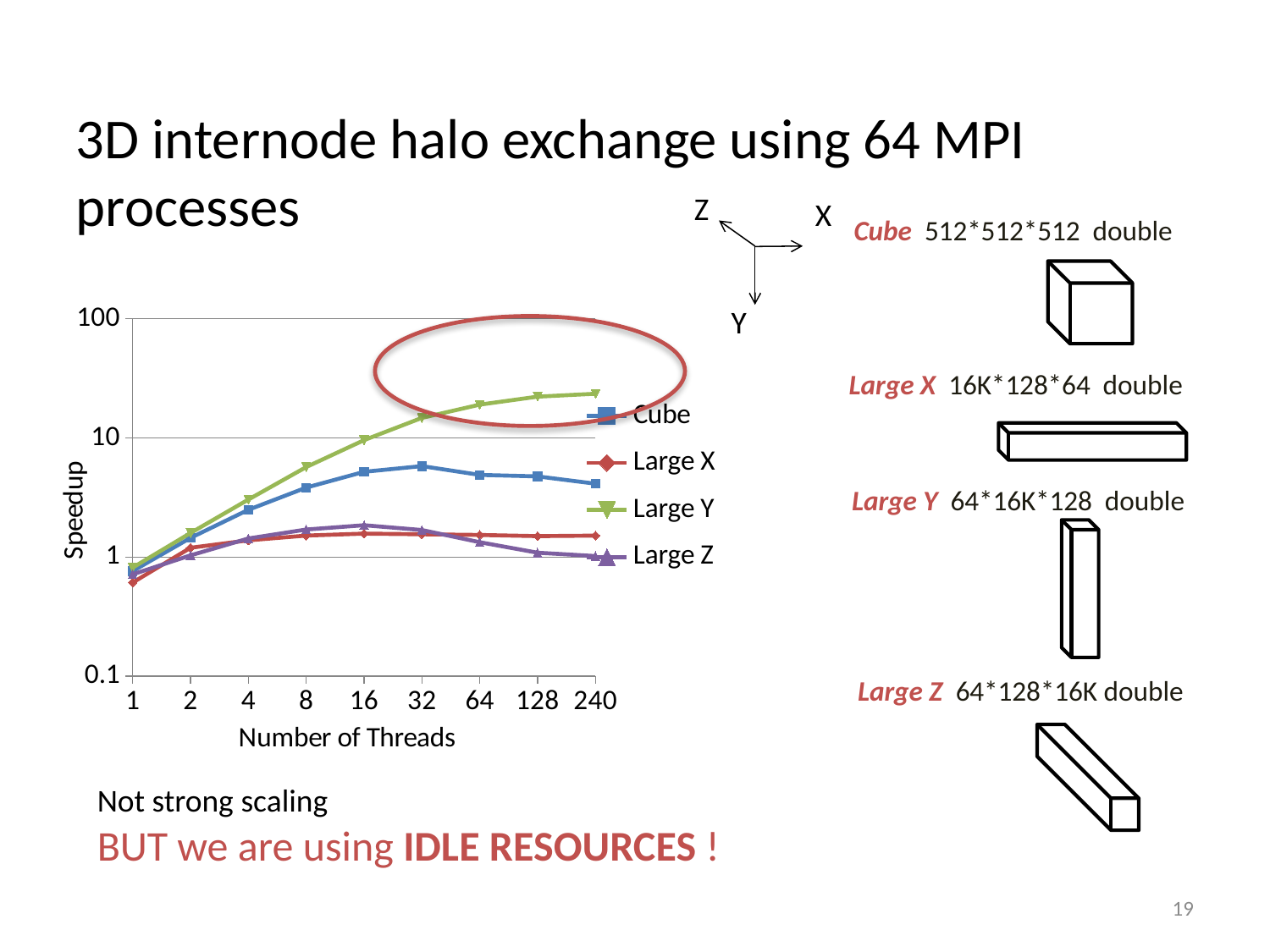
Does the speedup for Large Y rise or fall as the number of threads increases? rise Is the speedup for Large Y at 240 threads greater or less than 10? greater Is the speedup for Cube at 240 threads greater or less than 10? less Is the speedup for Large Z at 1 thread greater or less than 1? less What is the label of the chart's y axis? Speedup At 240 threads, which has the larger speedup, Large Y or Cube? Large Y Which series has the highest speedup at 240 threads? Large Y What kind of chart is shown on the slide? Line chart Which series has the lowest speedup at 240 threads? Large Z How many thread counts are plotted along the x axis of the chart? 9 How many series does the chart legend list? 4